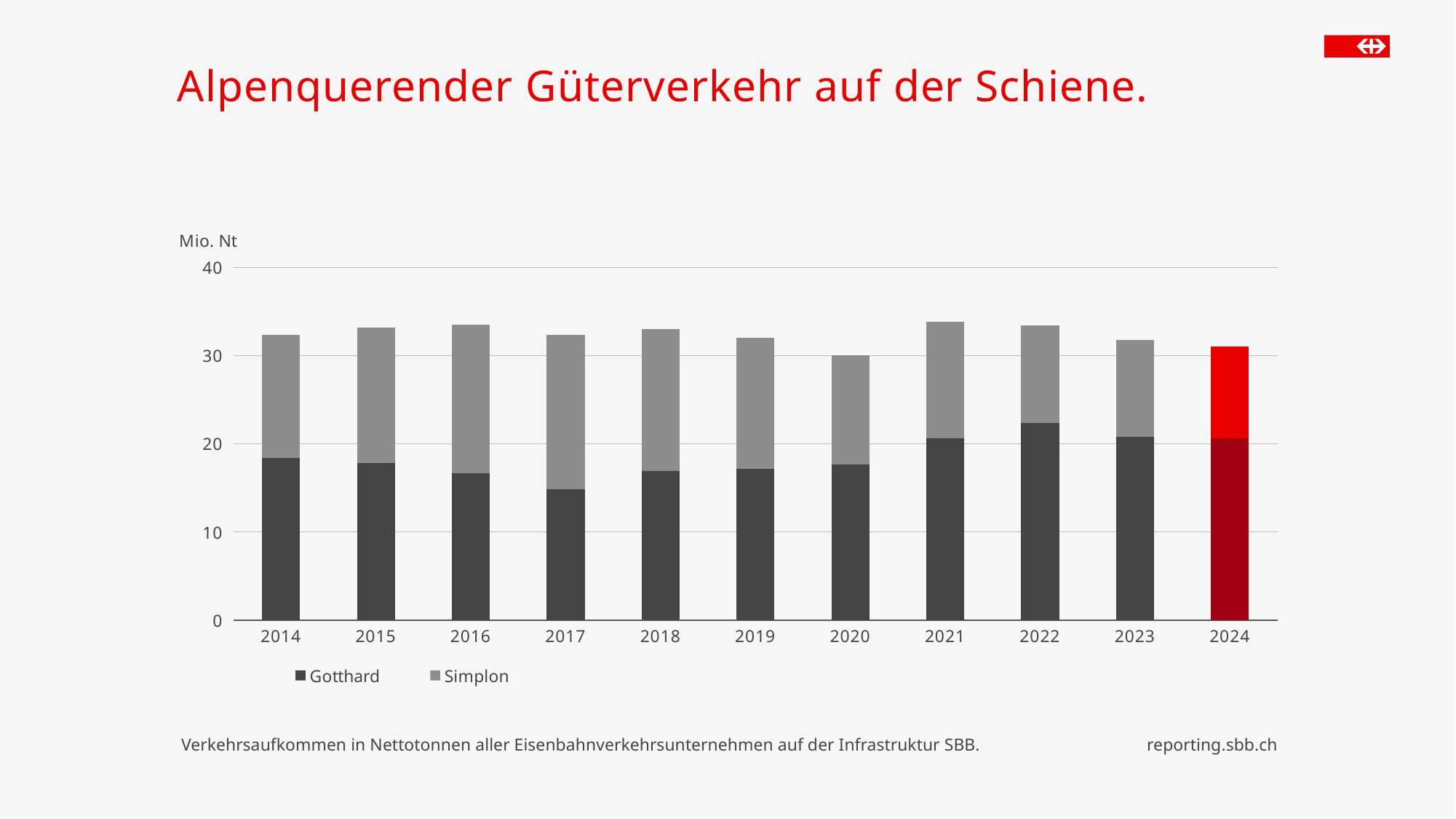
Is the Gotthard value for 2022 greater or less than 20? greater Which series are listed in the legend? Gotthard and Simplon What unit is shown on the y axis of the chart? Mio. Nt How many series does the legend list? 2 What kind of chart is shown on the slide? Stacked bar chart Which year has the larger Gotthard value, 2017 or 2022? 2022 In which year is the Gotthard value the lowest? 2017 How many years are shown on the x axis of the chart? 11 Is the Gotthard value for 2017 greater or less than 20? less Which year has the larger total stacked bar, 2020 or 2021? 2021 Is the total stacked value for 2014 greater or less than 30? greater In which year is the Gotthard value the highest? 2022